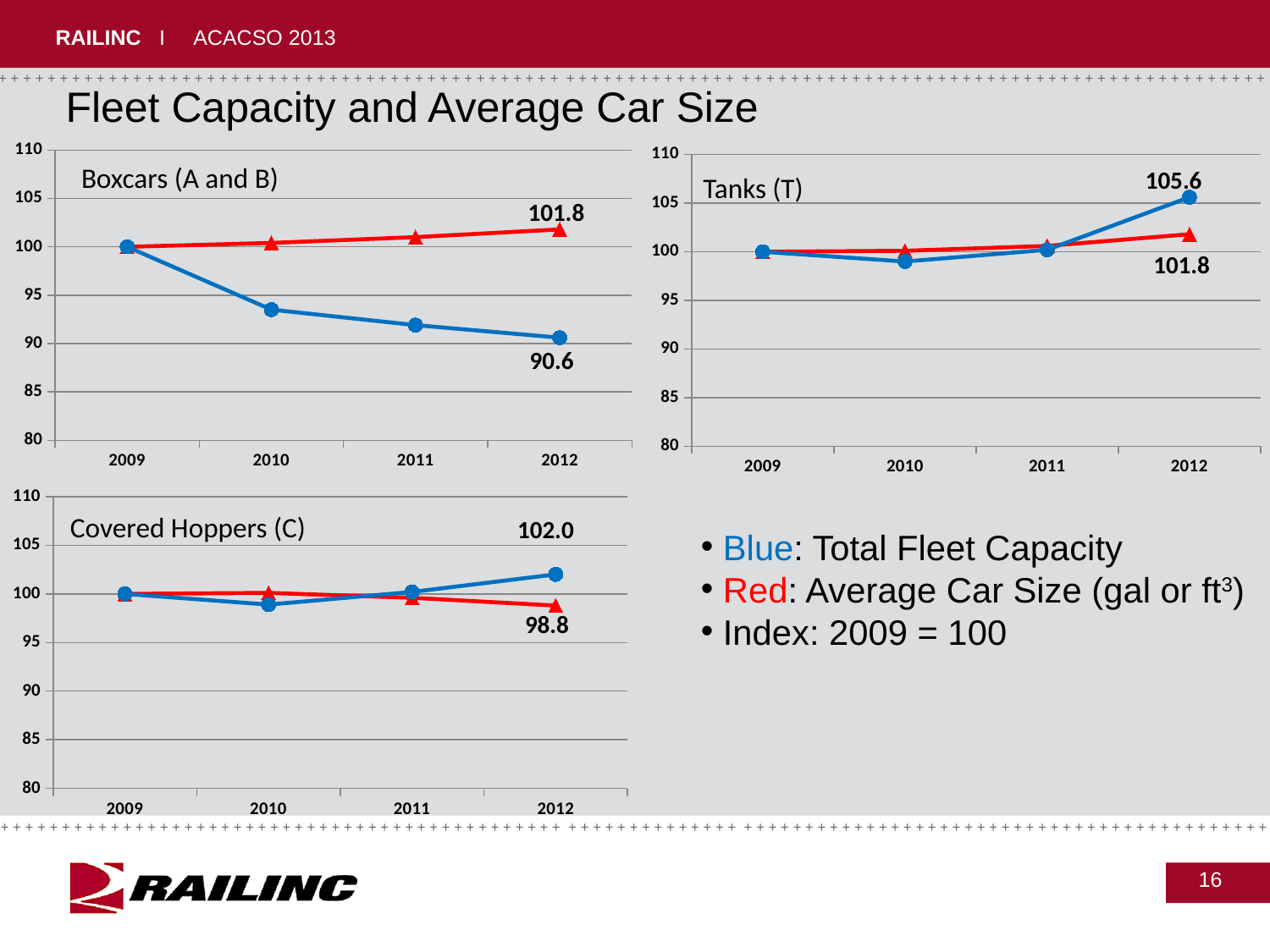
In the Tanks (T) chart, what is the value of the blue Total Fleet Capacity line in 2012? 105.6 In the Boxcars (A and B) chart, is the value of the blue line in 2010 greater or less than 95? less In the Boxcars (A and B) chart, what is the difference between the red and blue values in 2012? 11.2 In the Covered Hoppers (C) chart, what is the value of the red Average Car Size line in 2012? 98.8 In the Boxcars (A and B) chart, does the blue Total Fleet Capacity line rise or fall from 2009 to 2012? fall In the Boxcars (A and B) chart, what is the value of the red Average Car Size line in 2012? 101.8 According to the slide, what does the red line represent? Average Car Size (gal or ft³) In the Boxcars (A and B) chart, what is the value of the blue Total Fleet Capacity line in 2012? 90.6 How many years are plotted on the x axis of the Tanks (T) chart? 4 What kind of chart is the Covered Hoppers (C) chart? line chart In the Tanks (T) chart, what is the difference between the blue and red values in 2012? 3.8 In the Covered Hoppers (C) chart, which line has the higher value in 2012, blue or red? blue